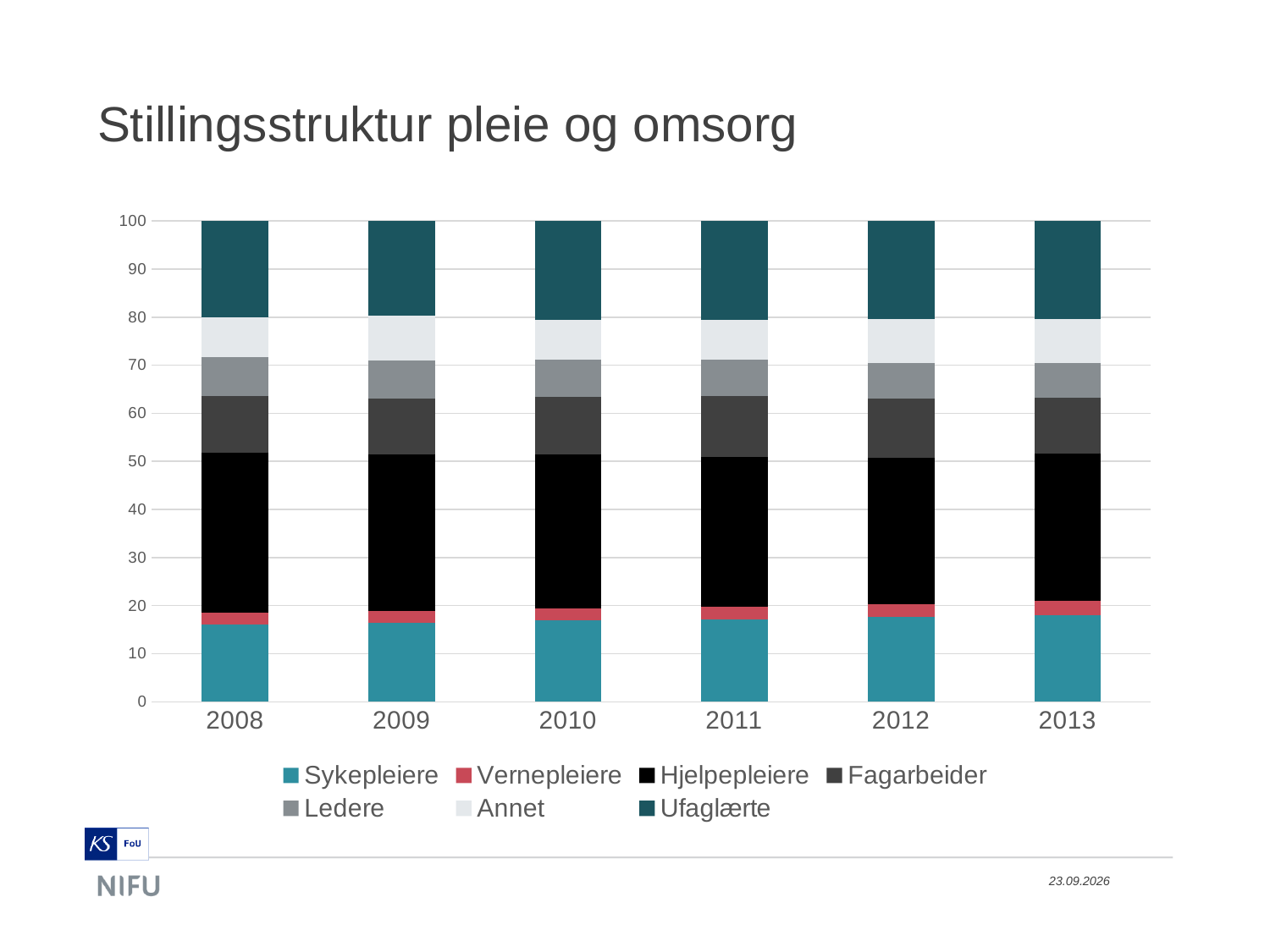
What kind of chart is shown on the slide? Stacked bar chart Is the value for Hjelpepleiere in 2008 greater or less than 30? greater Is the value for Vernepleiere in 2012 greater or less than 10? less Which series is shown at the bottom of each stacked bar? Sykepleiere How many years are shown on the x axis of the chart? 6 Is the value for Fagarbeider in 2011 greater or less than 10? greater What is the title of the chart on the slide? Stillingsstruktur pleie og omsorg Which is larger in 2013, the Hjelpepleiere segment or the Ledere segment? Hjelpepleiere What is the total height of the stacked bar for 2010? 100 How many series does the legend list? 7